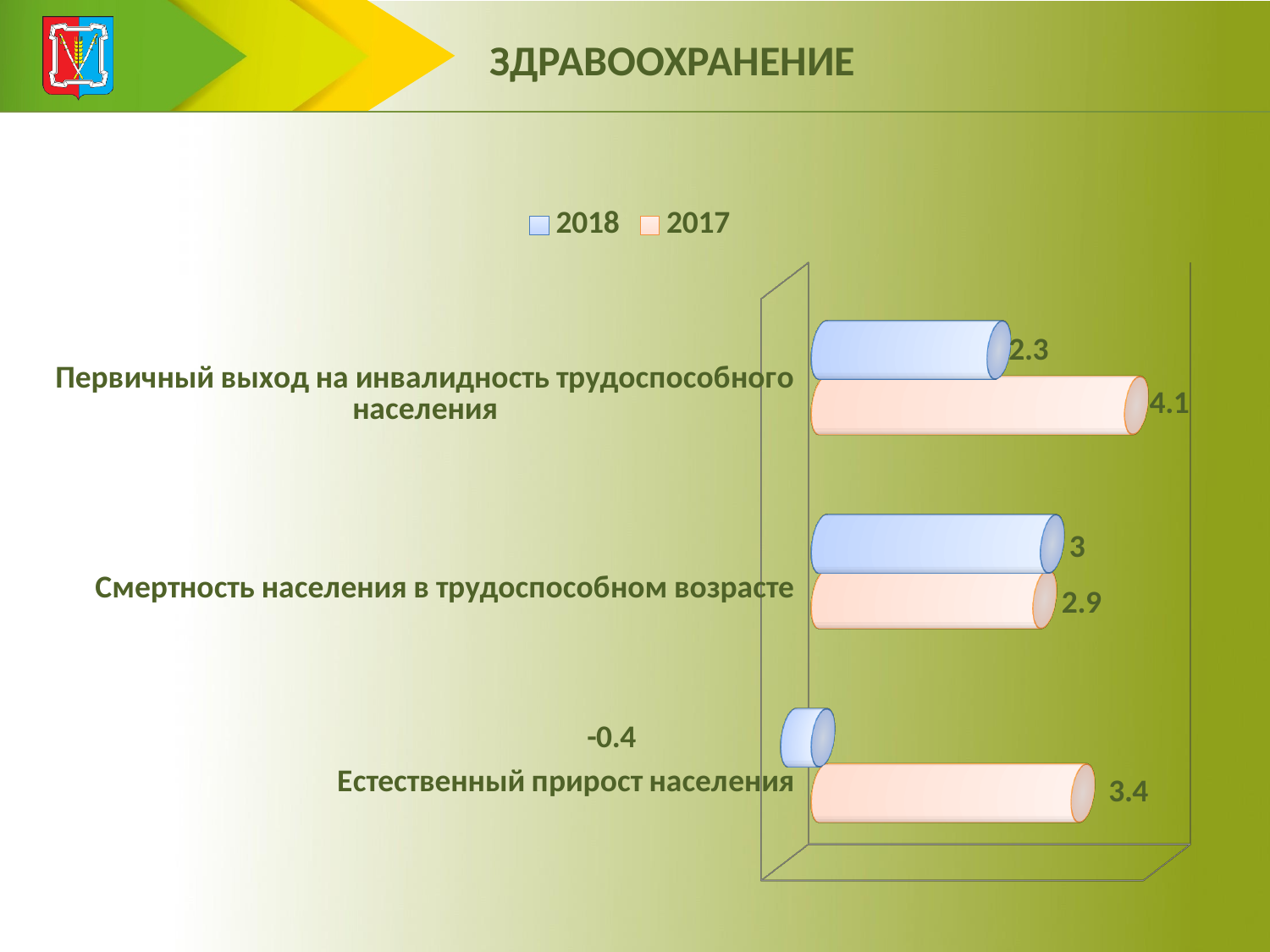
Which category has the highest 2017 value? Первичный выход на инвалидность трудоспособного населения What is the 2018 value for Смертность населения в трудоспособном возрасте? 3 What is the 2017 value for Первичный выход на инвалидность трудоспособного населения? 4.1 What is the difference between the 2017 and 2018 values for Первичный выход на инвалидность трудоспособного населения? 1.8 Which category has the lowest 2018 value? Естественный прирост населения What is the 2018 value for Естественный прирост населения? -0.4 For Естественный прирост населения, which year has the larger value, 2017 or 2018? 2017 What kind of chart is shown on the slide? Bar chart How many categories are shown in the chart? 3 How many series does the legend list? 2 What is the 2017 value for Естественный прирост населения? 3.4 What is the 2018 value for Первичный выход на инвалидность трудоспособного населения? 2.3